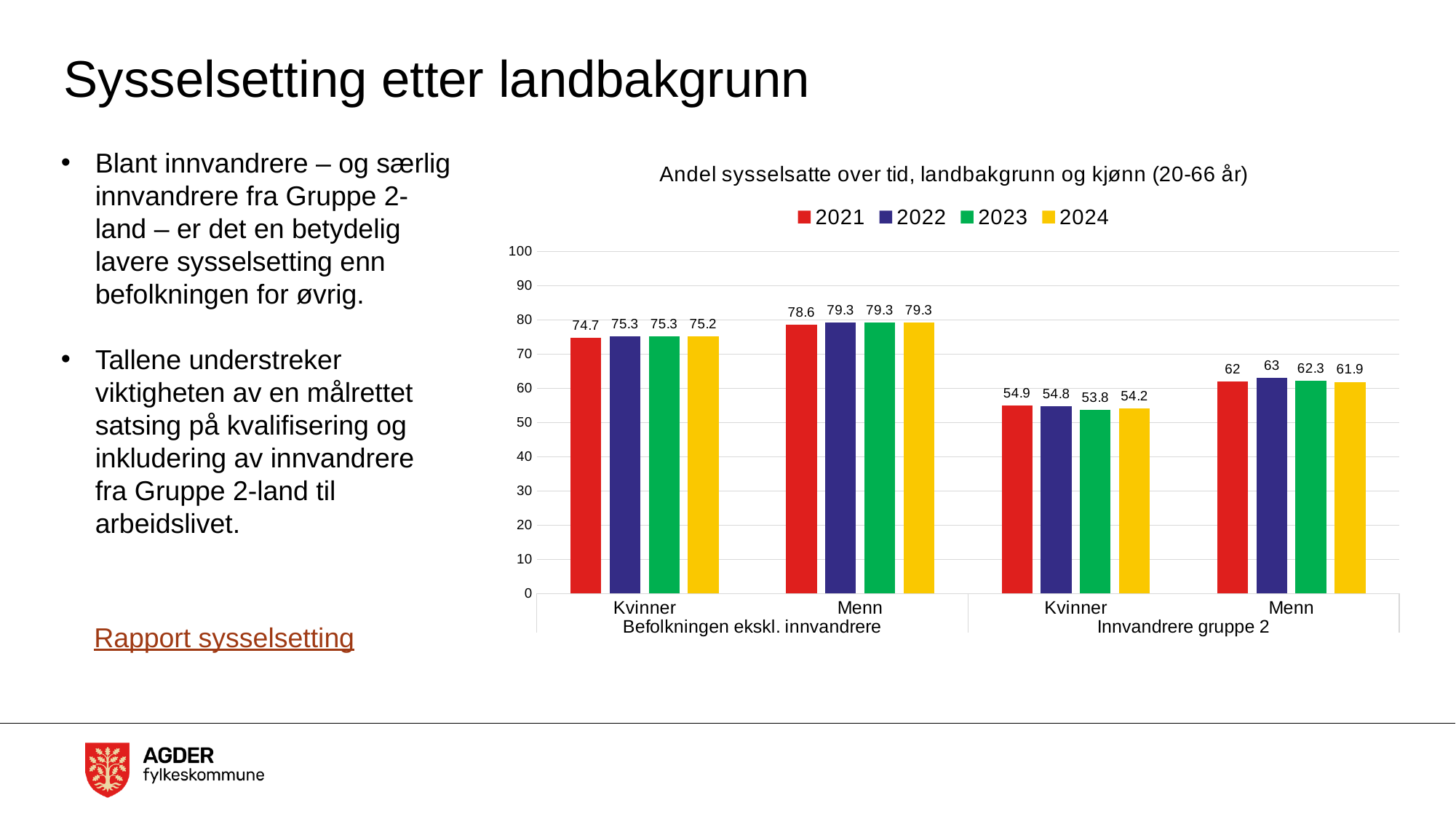
Is the 2022 value for Menn in Innvandrere gruppe 2 greater or less than 70? less What is the 2023 value for Kvinner in Innvandrere gruppe 2? 53.8 Which colour represents the 2024 series in the chart? yellow What is the 2024 value for Menn in Innvandrere gruppe 2? 61.9 What is the difference between the 2024 values for Menn in Befolkningen ekskl. innvandrere and Menn in Innvandrere gruppe 2? 17.4 How many series does the legend list? 4 Which category group and gender has the lowest 2024 value? Kvinner, Innvandrere gruppe 2 Which category group and gender has the highest 2022 value? Menn, Befolkningen ekskl. innvandrere What kind of chart is shown on the slide? bar chart Which is larger: the 2021 value for Kvinner in Innvandrere gruppe 2 or the 2021 value for Menn in Innvandrere gruppe 2? Menn in Innvandrere gruppe 2 What is the 2021 value for Kvinner in Befolkningen ekskl. innvandrere? 74.7 What is the title of the chart? Andel sysselsatte over tid, landbakgrunn og kjønn (20-66 år)